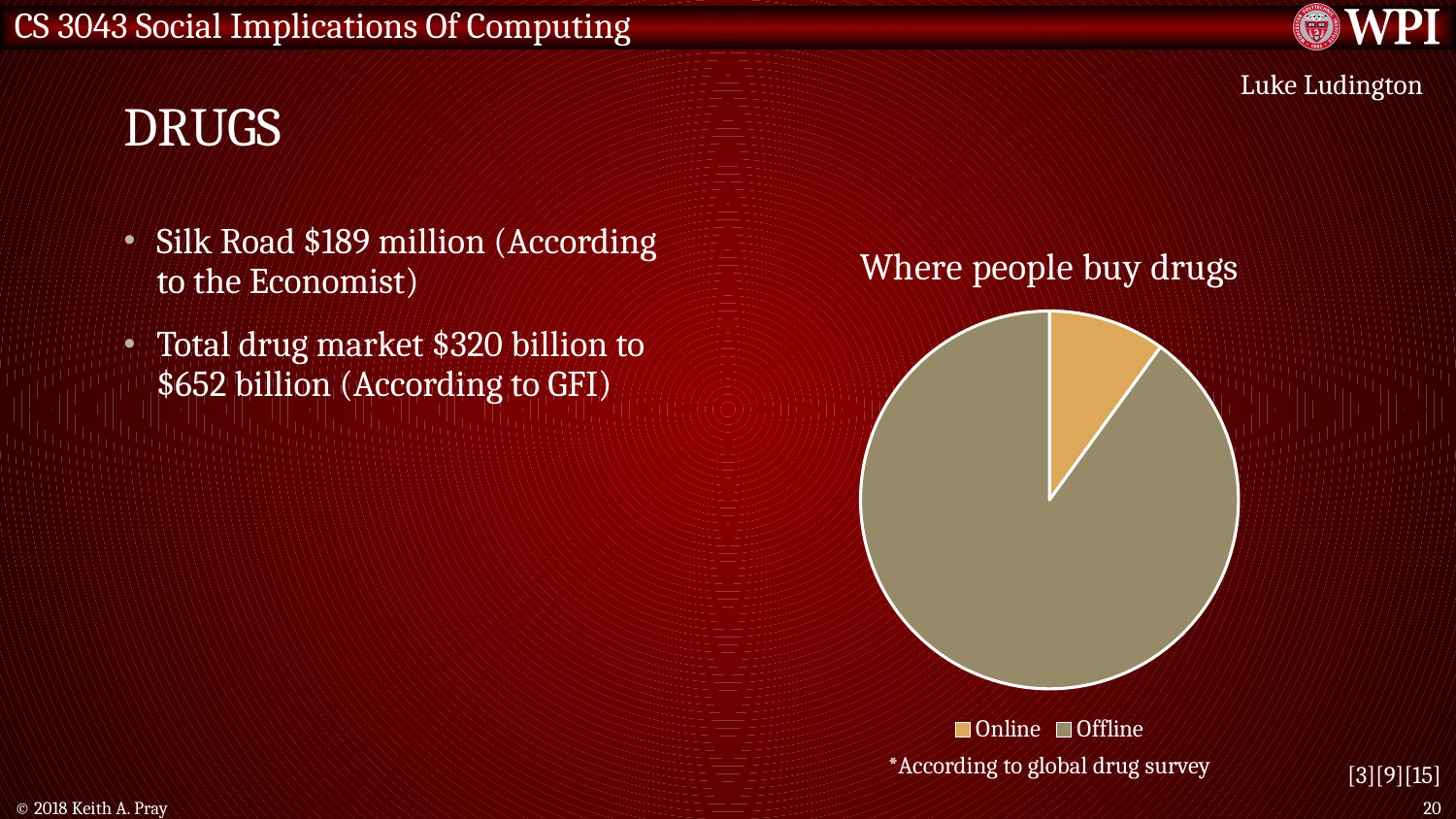
What kind of chart is shown on the slide? Pie chart How many slices does the pie chart have? 2 Which slice is larger, Online or Offline? Offline Which category has the smallest slice of the pie? Online What are the two categories shown in the chart's legend? Online and Offline Which category has the largest slice of the pie? Offline What colour is the Online slice in the pie chart? Orange How many entries does the chart's legend list? 2 What is the title of the chart? Where people buy drugs